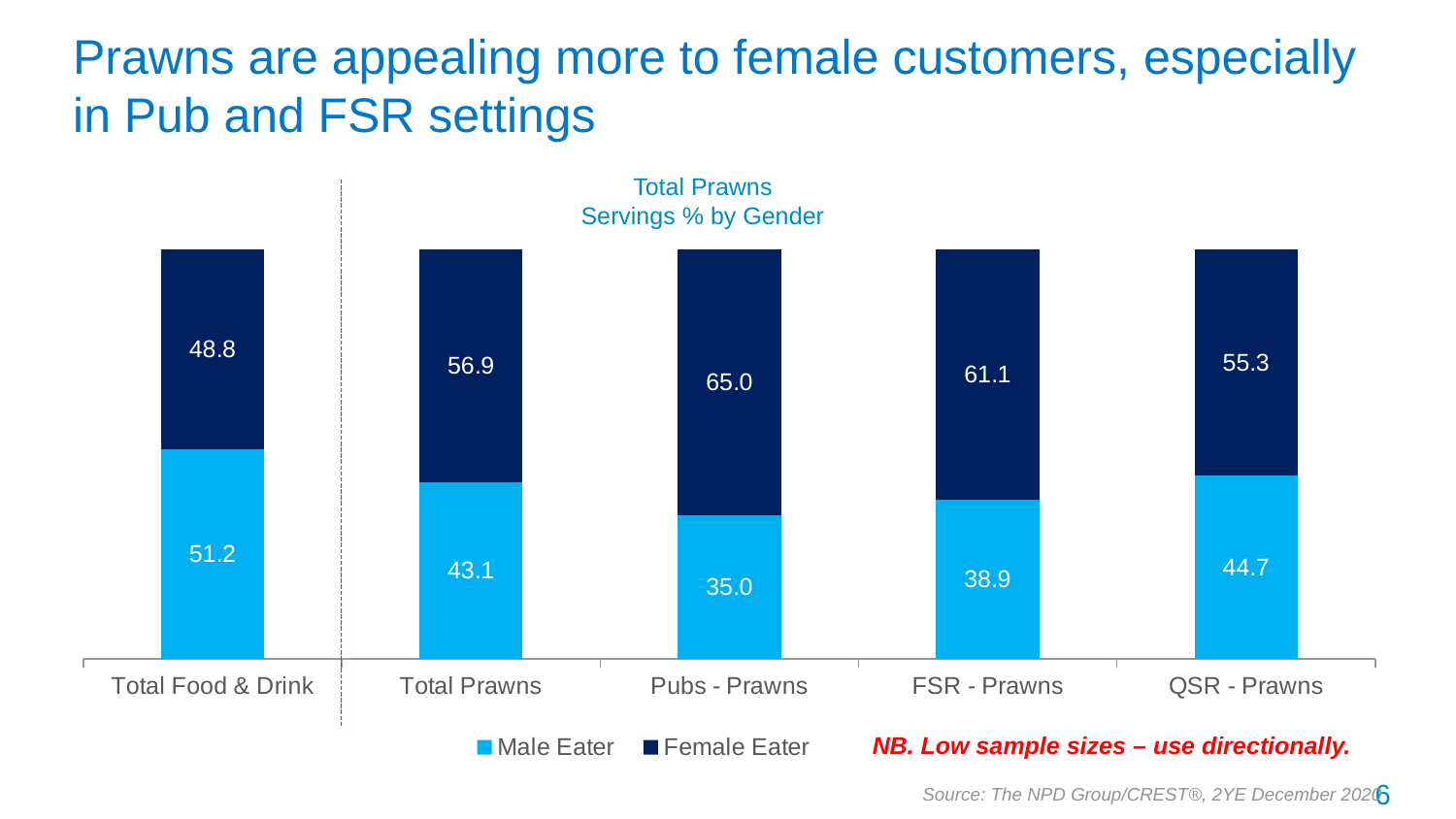
What is the Male Eater value for FSR - Prawns? 38.9 What is the difference between the Female Eater and Male Eater values for Total Prawns? 13.8 What kind of chart is shown on the slide? Stacked bar chart Which is larger, the Male Eater value for QSR - Prawns or the Male Eater value for FSR - Prawns? QSR - Prawns What is the Female Eater value for Pubs - Prawns? 65.0 What is the Male Eater value for Total Food & Drink? 51.2 How many series does the legend list? 2 Which category has the lowest Male Eater value? Pubs - Prawns What is the total of the stacked bar for QSR - Prawns? 100.0 How many categories are shown on the x axis? 5 What is the title of the chart? Total Prawns Servings % by Gender Which category has the highest Female Eater value? Pubs - Prawns